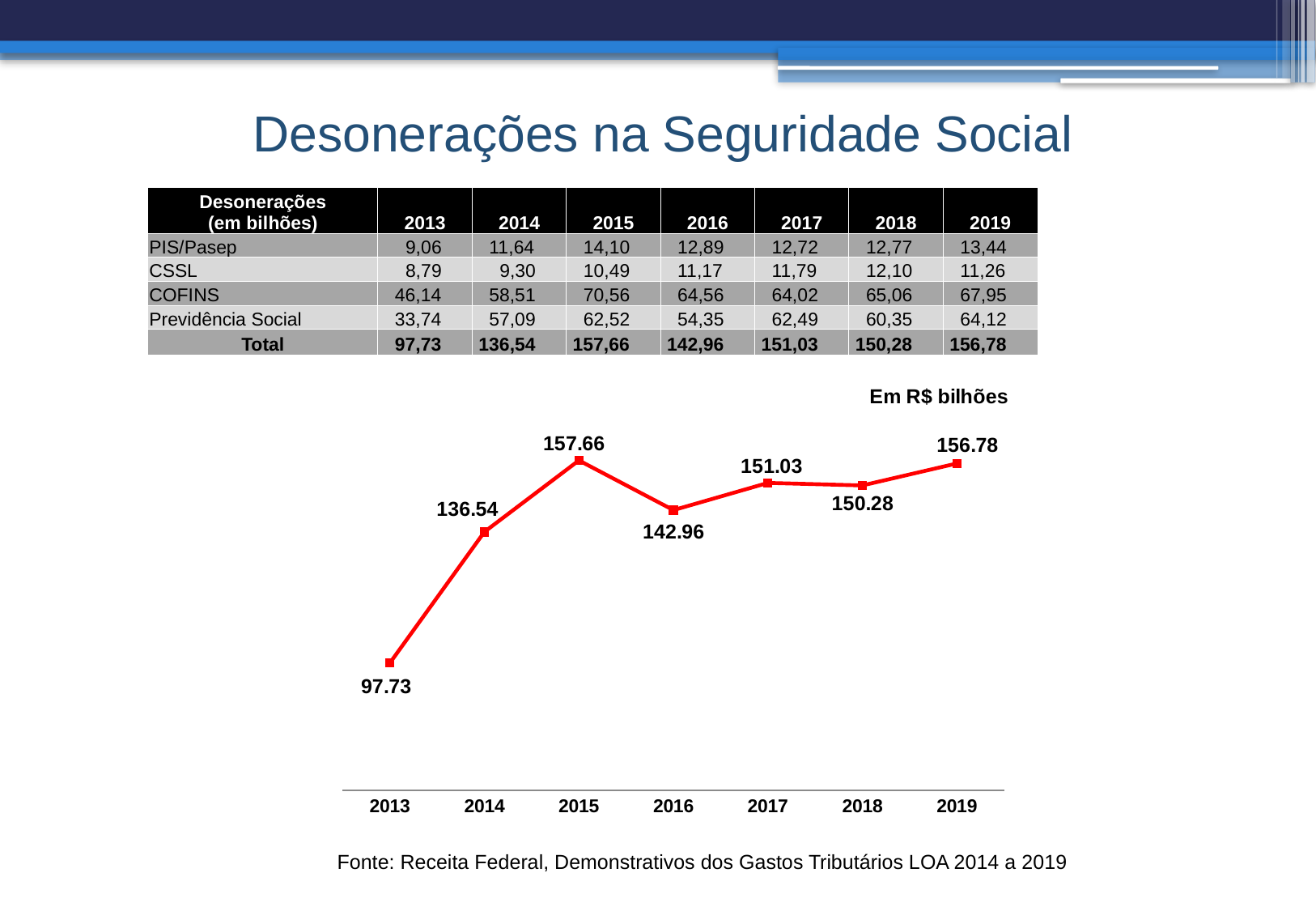
Does the value in the line chart rise or fall from 2013 to 2015? rise What value does the line chart show for 2018? 150.28 How many data points are plotted in the line chart? 7 What is the difference between the 2014 and 2013 values in the line chart? 38.81 What is the difference between the 2015 and 2016 values in the line chart? 14.70 Which year has the highest value in the line chart? 2015 What unit label is shown above the line chart? Em R$ bilhões What value does the line chart show for 2013? 97.73 What kind of chart is shown on the slide? line chart Which year has the lowest value in the line chart? 2013 In the line chart, which is larger, the value for 2017 or the value for 2019? 2019 What value does the line chart show for 2015? 157.66